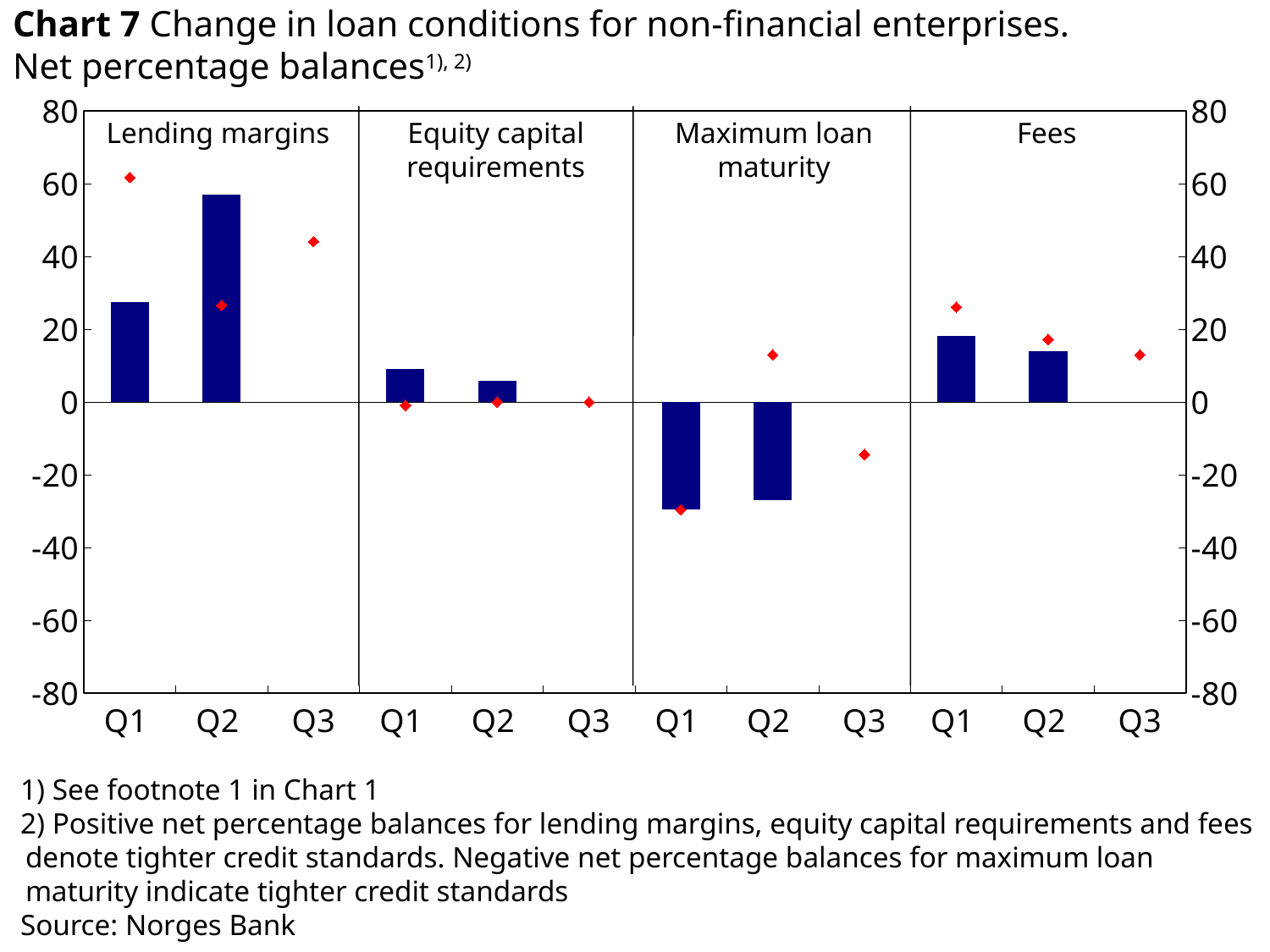
How many loan-condition panels does the chart show? 4 Which bar has the lowest value in the chart? Maximum loan maturity Q1 In the Lending margins panel, which bar is larger, Q1 or Q2? Q2 Is the Q1 bar for Equity capital requirements greater or less than 20? less Which panel contains the tallest bar in the chart? Lending margins Is the Q1 bar for Lending margins greater or less than 20? greater What kind of chart is shown on the slide? bar chart Is the Q2 bar for Lending margins greater or less than 40? greater In the Fees panel, which bar is larger, Q1 or Q2? Q1 What is the source given for the chart? Norges Bank